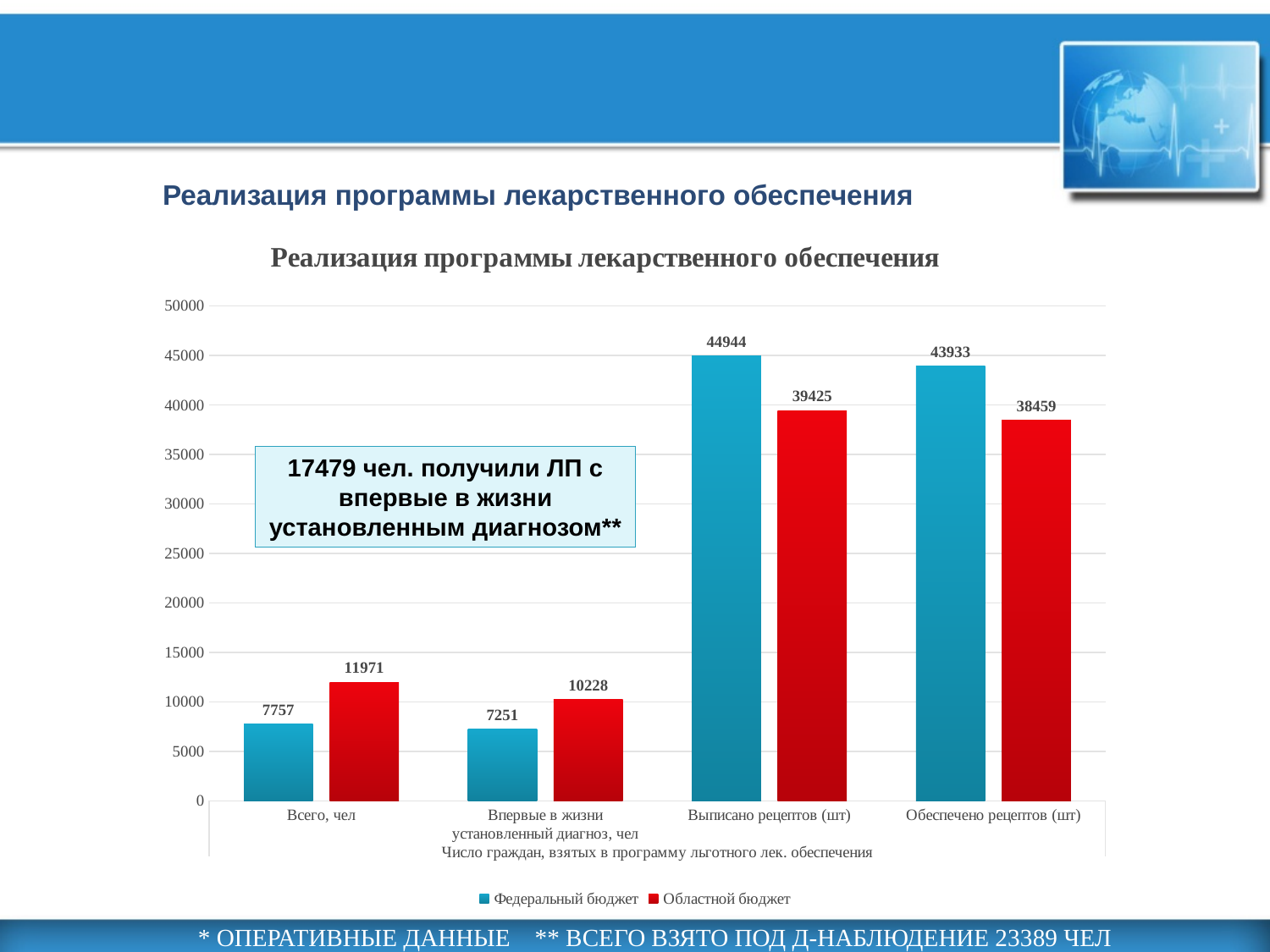
What is the value for Федеральный бюджет in the category Всего, чел? 7757 What is the difference between Областной бюджет and Федеральный бюджет in the category Всего, чел? 4214 How many categories are shown on the x axis of the chart? 4 Which category has the lowest value for Областной бюджет? Впервые в жизни установленный диагноз, чел In the category Обеспечено рецептов (шт), which series has the larger value, Федеральный бюджет or Областной бюджет? Федеральный бюджет What is the value for Областной бюджет in the category Выписано рецептов (шт)? 39425 What kind of chart is shown on the slide? bar chart What is the title of the chart? Реализация программы лекарственного обеспечения How many series does the legend list? 2 Which category has the highest value for Федеральный бюджет? Выписано рецептов (шт) Is the value for Областной бюджет in the category Впервые в жизни установленный диагноз, чел greater or less than 10000? greater What is the value for Федеральный бюджет in the category Обеспечено рецептов (шт)? 43933